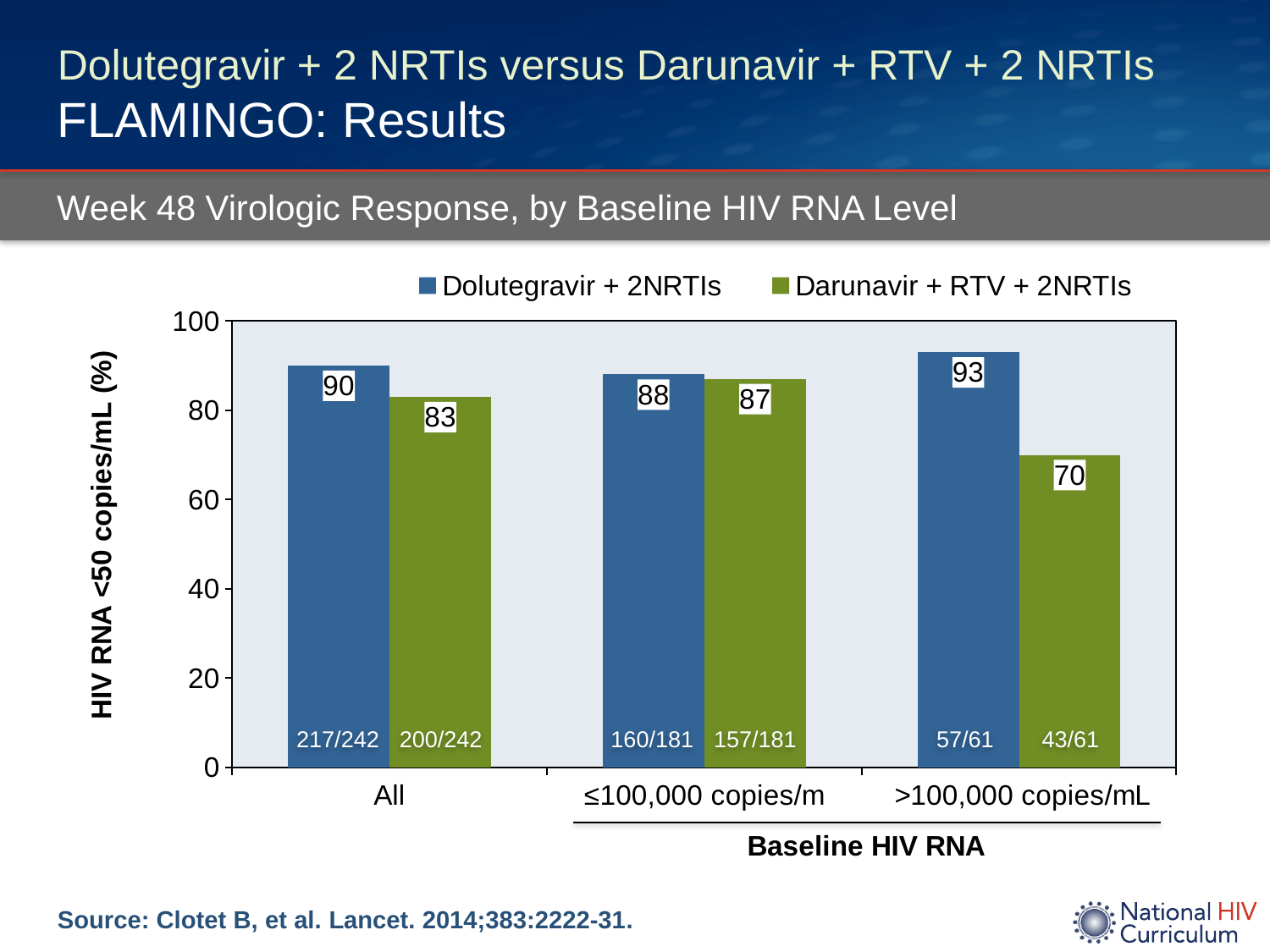
Which series has the larger value in the ≤100,000 copies/m category? Dolutegravir + 2NRTIs What is the value for Darunavir + RTV + 2NRTIs in the >100,000 copies/mL category? 70 How many baseline HIV RNA categories are shown on the x axis? 3 What is the value for Darunavir + RTV + 2NRTIs in the ≤100,000 copies/m category? 87 What kind of chart is shown on the slide? Bar chart Which baseline HIV RNA category has the highest value for Dolutegravir + 2NRTIs? >100,000 copies/mL What is the difference between Dolutegravir + 2NRTIs and Darunavir + RTV + 2NRTIs in the >100,000 copies/mL category? 23 What is the value for Dolutegravir + 2NRTIs in the All category? 90 Which baseline HIV RNA category has the lowest value for Darunavir + RTV + 2NRTIs? >100,000 copies/mL What fraction is printed at the base of the Darunavir + RTV + 2NRTIs bar in the All category? 200/242 How many series does the legend list? 2 What is the difference between Dolutegravir + 2NRTIs and Darunavir + RTV + 2NRTIs in the All category? 7